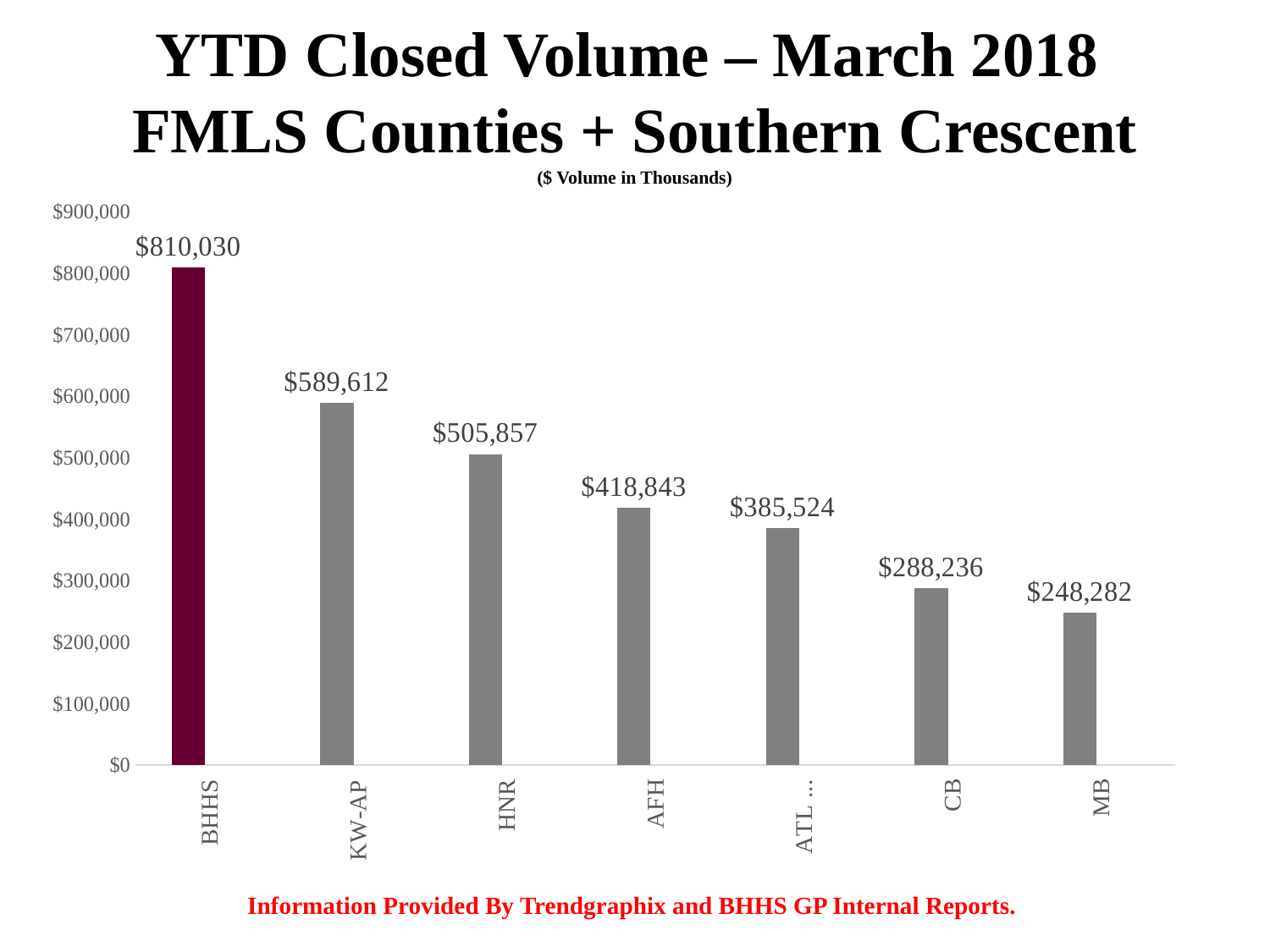
Which has a larger YTD closed volume, HNR or AFH? HNR Which company has the highest YTD closed volume? BHHS Is the value for AFH greater or less than $400,000? greater What is the difference between the YTD closed volume of CB and MB? $39,954 Which company has the lowest YTD closed volume? MB What kind of chart is shown on the slide? Bar chart What is the YTD closed volume for BHHS? $810,030 What is the YTD closed volume for HNR? $505,857 How many bars are shown in the chart? 7 What is the difference between the YTD closed volume of BHHS and KW-AP? $220,418 What is the YTD closed volume for KW-AP? $589,612 What is the YTD closed volume for MB? $248,282